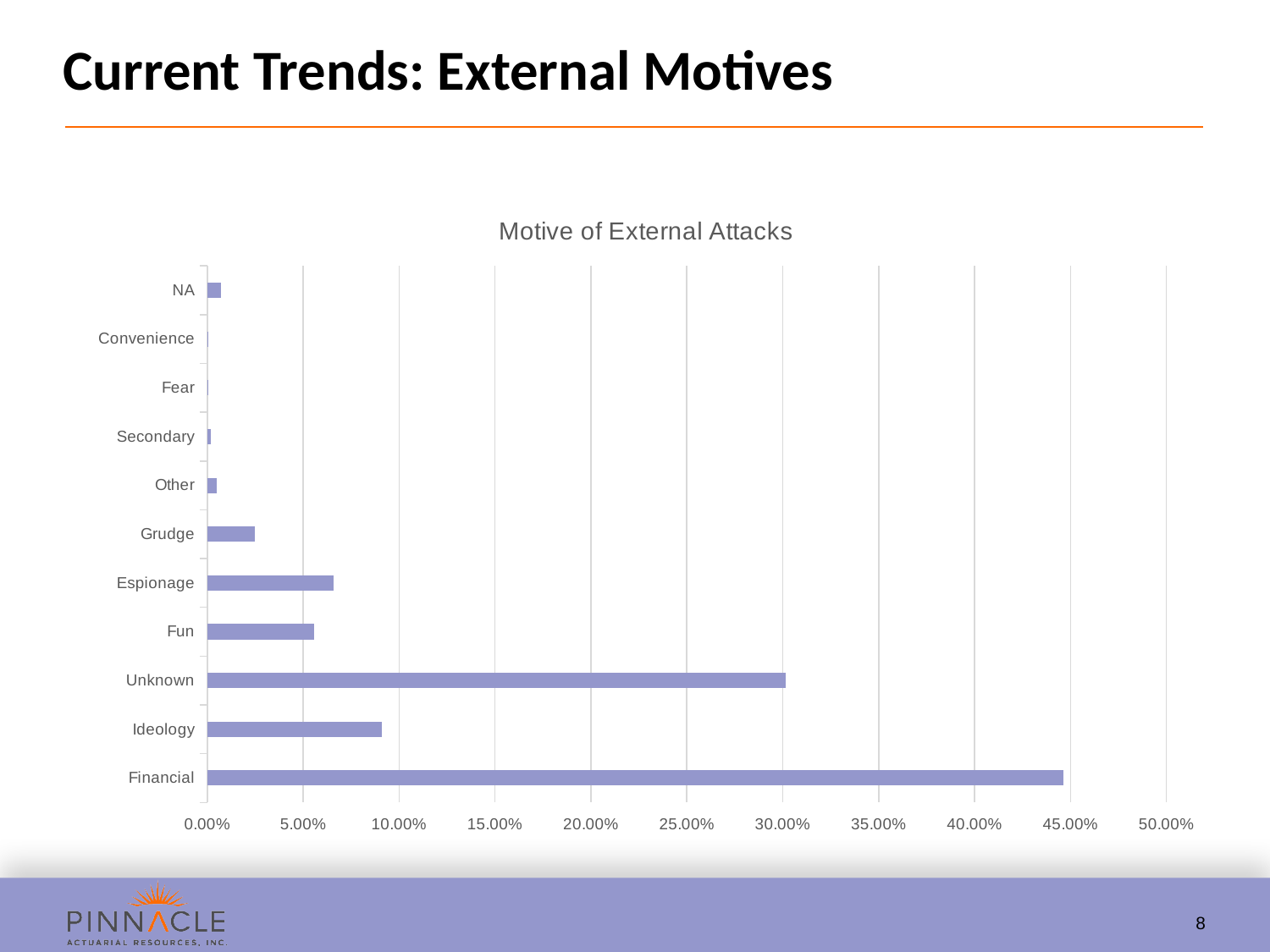
Is the value for Grudge greater or less than 5.00%? less Which is larger, the value for Unknown or the value for Ideology? Unknown Which is larger, the value for Ideology or the value for Espionage? Ideology What is the title of the chart? Motive of External Attacks Which is larger, the value for Grudge or the value for Fun? Fun How many motive categories are plotted in the chart? 11 Is the value for Ideology greater or less than 10.00%? less Is the value for Financial greater or less than 40.00%? greater Which motive has the highest value in the chart? Financial What type of chart is shown on the slide? bar chart